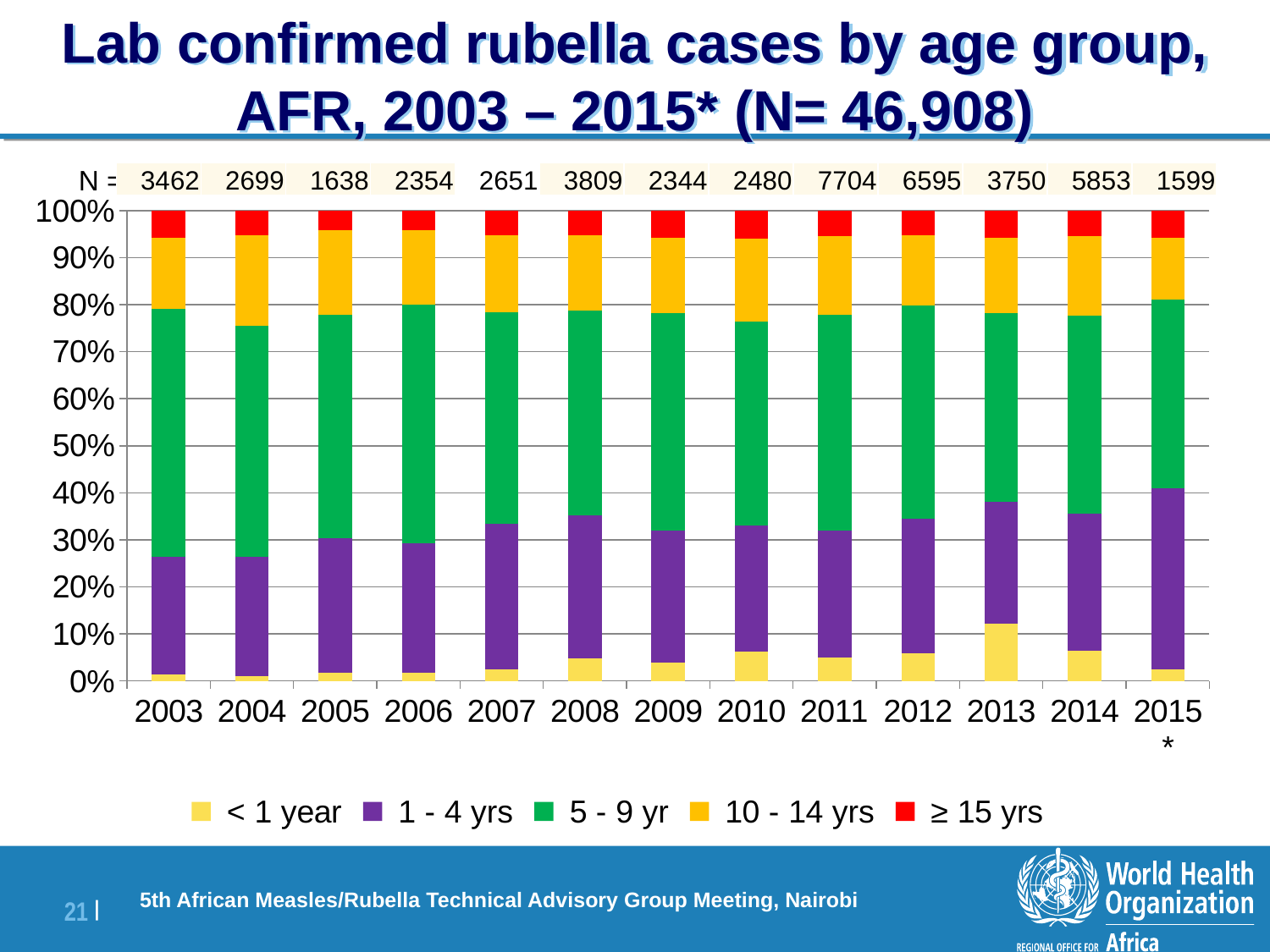
How many age-group series does the legend list? 5 What is the N value printed above the bar for 2005? 1638 Is the share of the 1 - 4 yrs group in 2003 greater or less than 30%? less Is the share of the ≥ 15 yrs group in 2003 greater or less than 10%? less What kind of chart is shown on the slide? stacked bar chart Which year has a larger N value, 2008 or 2013? 2008 What is the difference between the N values for 2011 and 2012? 1109 What is the N value printed above the bar for 2011? 7704 Which age group is shown in green in the legend? 5 - 9 yr Which year has the lowest N value printed above its bar? 2015 How many years (categories) are shown along the x axis? 13 Which year has the highest N value printed above its bar? 2011